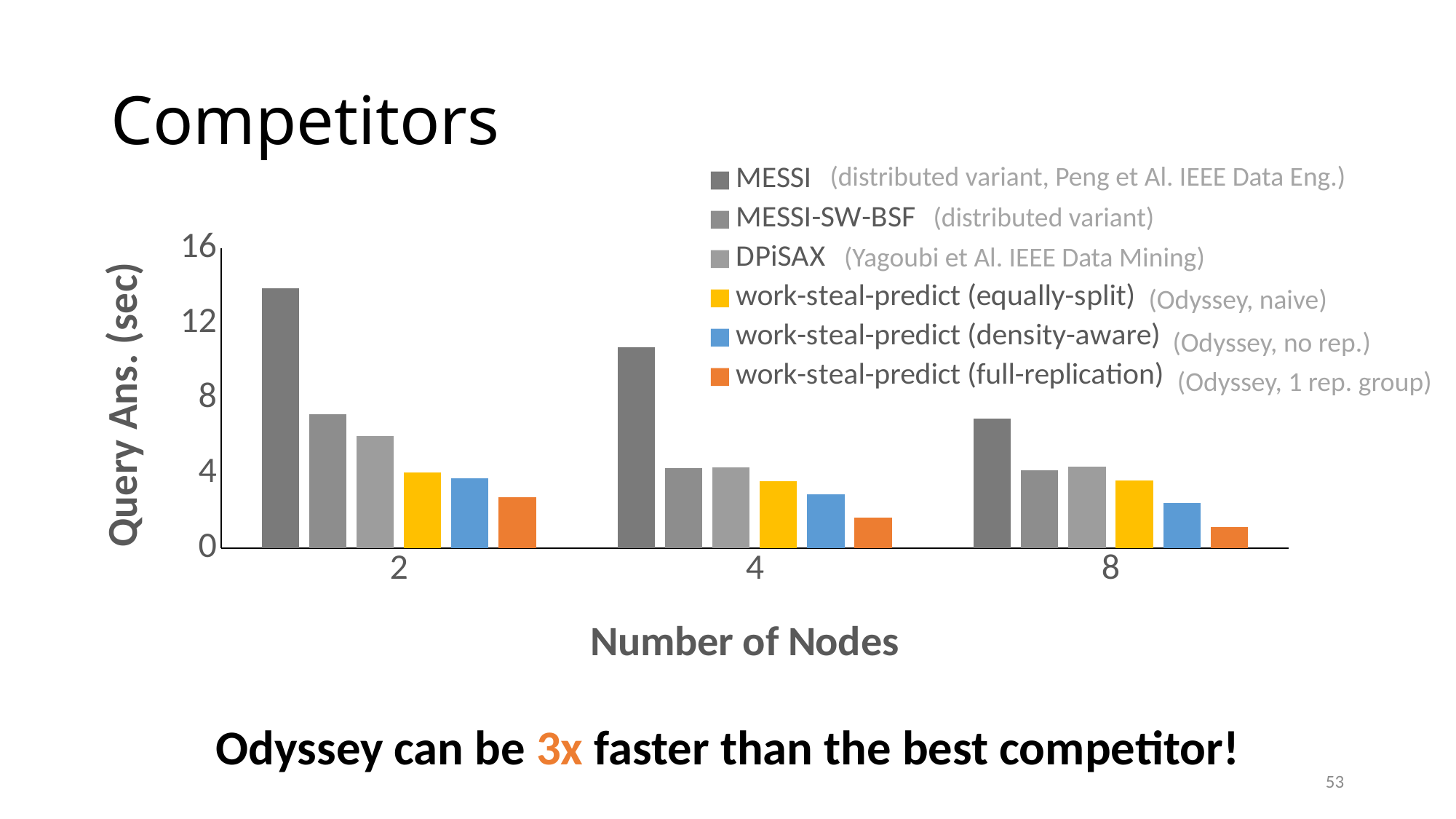
What is the label of the y axis? Query Ans. (sec) Is the value for MESSI at 4 nodes greater or less than 8? greater What kind of chart is shown on the slide? bar chart Is the value for MESSI at 2 nodes greater or less than 12? greater Is the value for MESSI at 8 nodes greater or less than 8? less How many series does the legend list? 6 Which is larger: the MESSI value at 2 nodes or the MESSI value at 4 nodes? MESSI at 2 nodes Which series has the lowest Query Ans. (sec) at 8 nodes? work-steal-predict (full-replication) Which series has the highest Query Ans. (sec) at 2 nodes? MESSI How many Number of Nodes categories are shown on the x axis? 3 Does the Query Ans. (sec) for MESSI rise or fall as the Number of Nodes increases from 2 to 8? fall